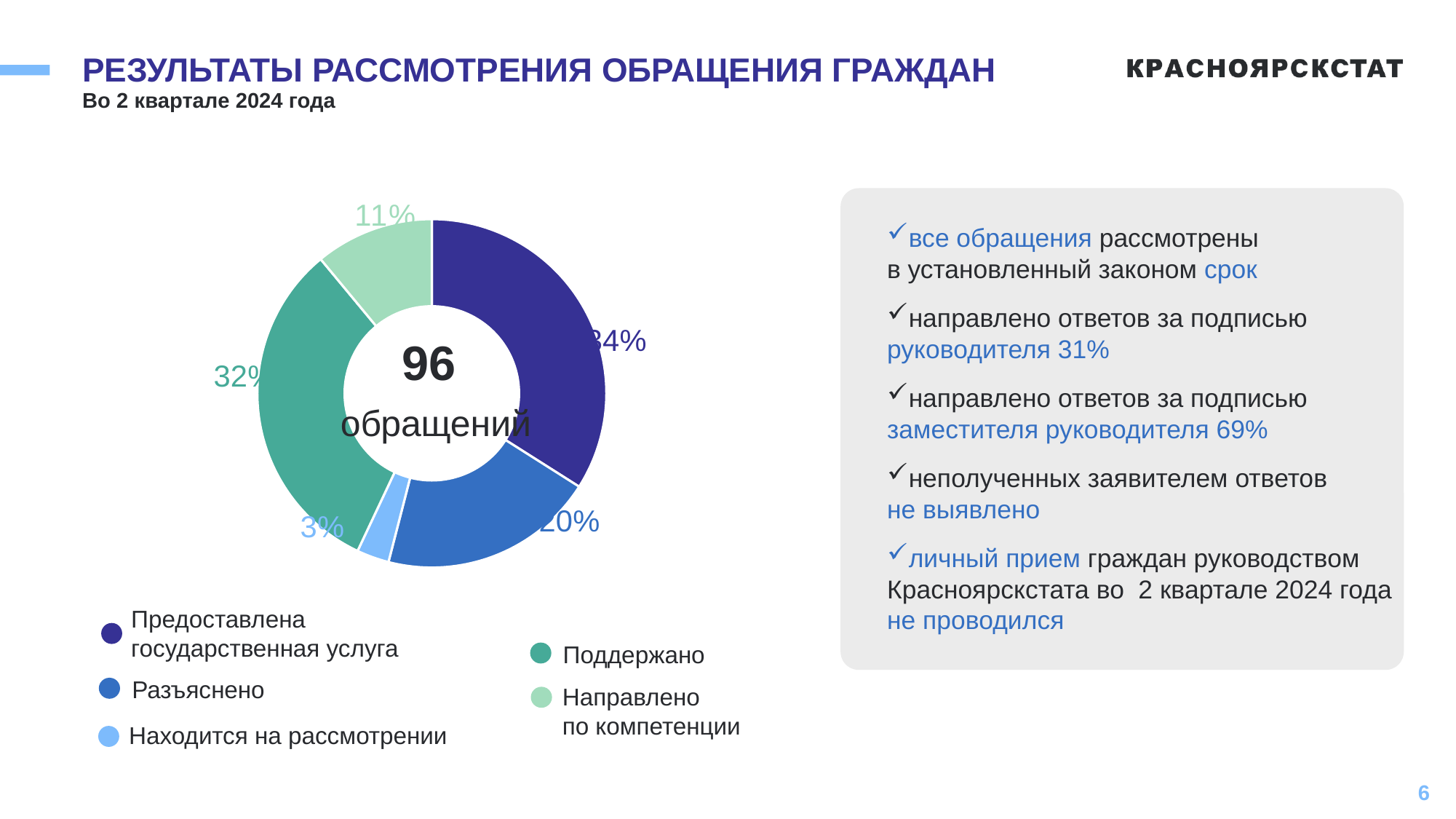
What total number of appeals is shown in the centre of the chart? 96 обращений Which is larger: the share for "Разъяснено" or for "Находится на рассмотрении"? Разъяснено What is the title of the slide containing the chart? РЕЗУЛЬТАТЫ РАССМОТРЕНИЯ ОБРАЩЕНИЯ ГРАЖДАН By how many percentage points does "Поддержано" exceed "Направлено по компетенции"? 21 What kind of chart is shown on the slide? donut (pie) chart Which is larger: the share for "Поддержано" or for "Направлено по компетенции"? Поддержано What share of the chart is labelled "Находится на рассмотрении"? 3% How many categories does the chart show? 5 What share of the chart is labelled "Направлено по компетенции"? 11% What share of the chart is labelled "Разъяснено"? 20% What share of the chart is labelled "Поддержано"? 32% Which category has the smallest share of the chart? Находится на рассмотрении